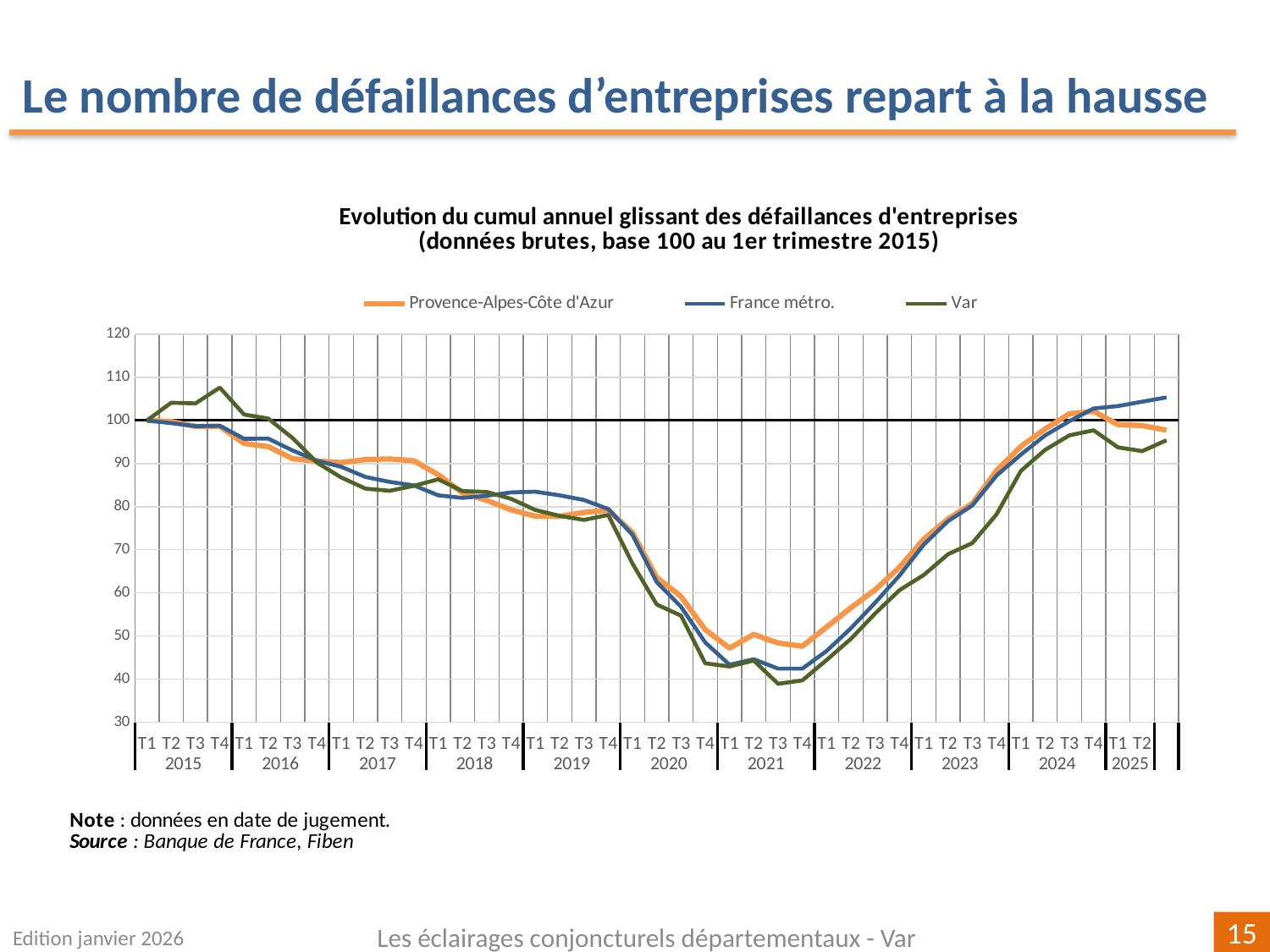
At T2 2025, which series is higher: France métro. or Var? France métro. Is the value for Var at T4 2015 greater or less than 100? greater Is the value for Var at T3 2021 greater or less than 50? less Which series reaches the lowest point on the chart? Var Is the value for France métro. at T2 2025 greater or less than 100? greater Which series is drawn in orange? Provence-Alpes-Côte d'Azur At T4 2021, which series is higher: Provence-Alpes-Côte d'Azur or Var? Provence-Alpes-Côte d'Azur Do the values rise or fall between T1 2020 and T4 2021? Fall What kind of chart is shown on the slide? Line chart How many series does the legend list? 3 What is the value of each series at T1 2015, the base period? 100